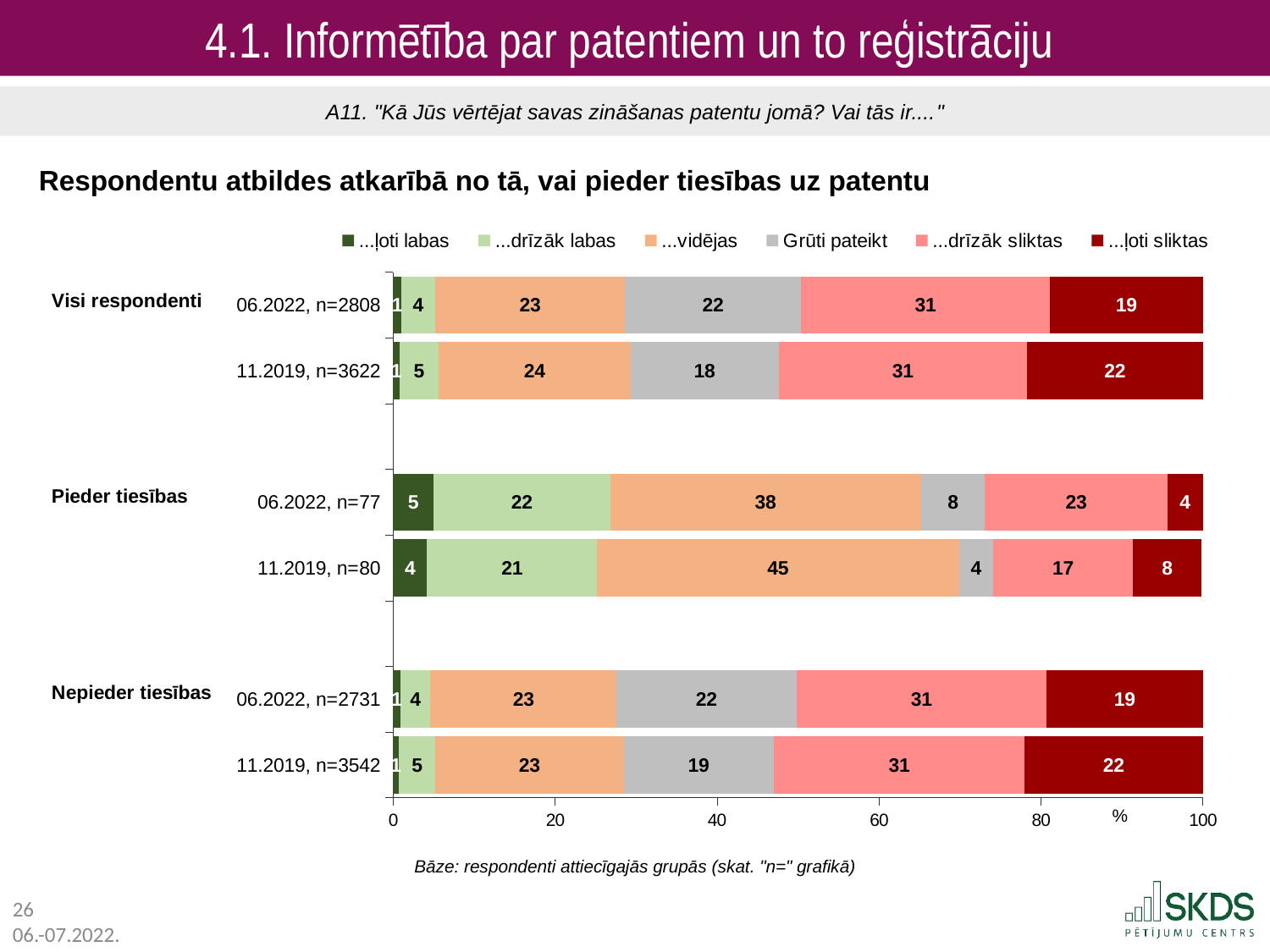
What is the value of "Grūti pateikt" for the "Nepieder tiesības" 11.2019, n=3542 bar? 19 What colour represents the "...ļoti sliktas" series in the legend? Dark red Which is larger: the "...vidējas" value for "Pieder tiesības" 06.2022, n=77 or for "Pieder tiesības" 11.2019, n=80? 11.2019, n=80 How many bars are plotted in the chart? 6 What is the value of "...vidējas" for the "Pieder tiesības" 11.2019, n=80 bar? 45 How many series does the legend list? 6 Which bar has the lowest value for "...ļoti sliktas"? Pieder tiesības, 06.2022, n=77 What is the total of the "Pieder tiesības" 06.2022, n=77 stacked bar? 100 What is the difference between the "...ļoti sliktas" values for "Visi respondenti" 11.2019, n=3622 and 06.2022, n=2808? 3 What type of chart is shown on the slide? Stacked bar chart What is the value of "...ļoti sliktas" for the "Visi respondenti" 06.2022, n=2808 bar? 19 Which bar has the highest value for "...drīzāk labas"? Pieder tiesības, 06.2022, n=77